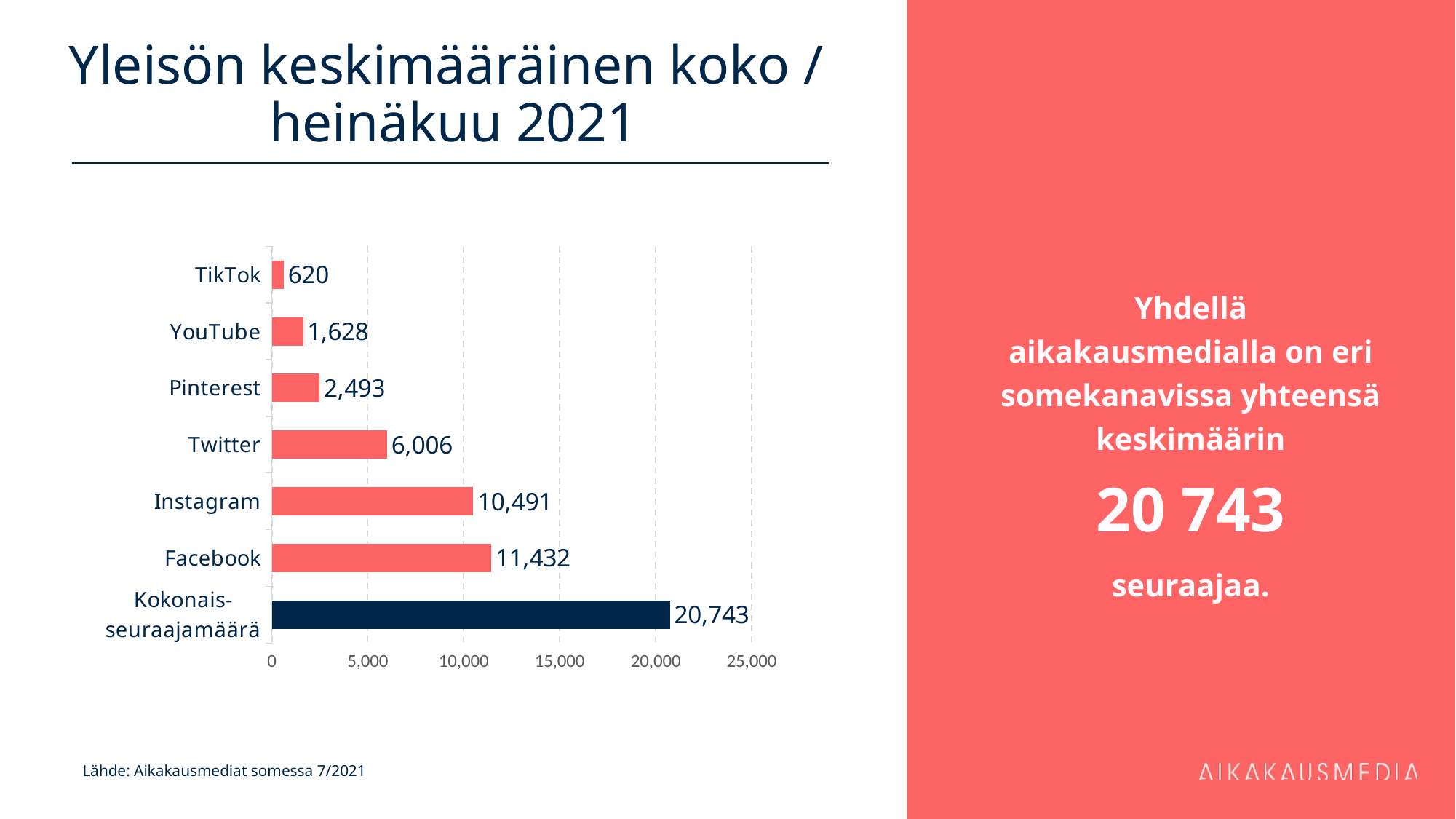
Is the value for Instagram greater or less than 10,000? greater How many categories are shown in the chart? 7 What is the difference between the values for YouTube and TikTok? 1,008 What is the value for Facebook? 11,432 What kind of chart is shown on the slide? bar chart Which is larger, the value for Twitter or the value for Pinterest? Twitter What is the value for TikTok? 620 What is the value for Kokonais-seuraajamäärä? 20,743 Which category has the lowest value? TikTok What is the difference between the values for Facebook and Instagram? 941 Which individual social media channel has the highest value? Facebook What is the title of the chart on the slide? Yleisön keskimääräinen koko / heinäkuu 2021